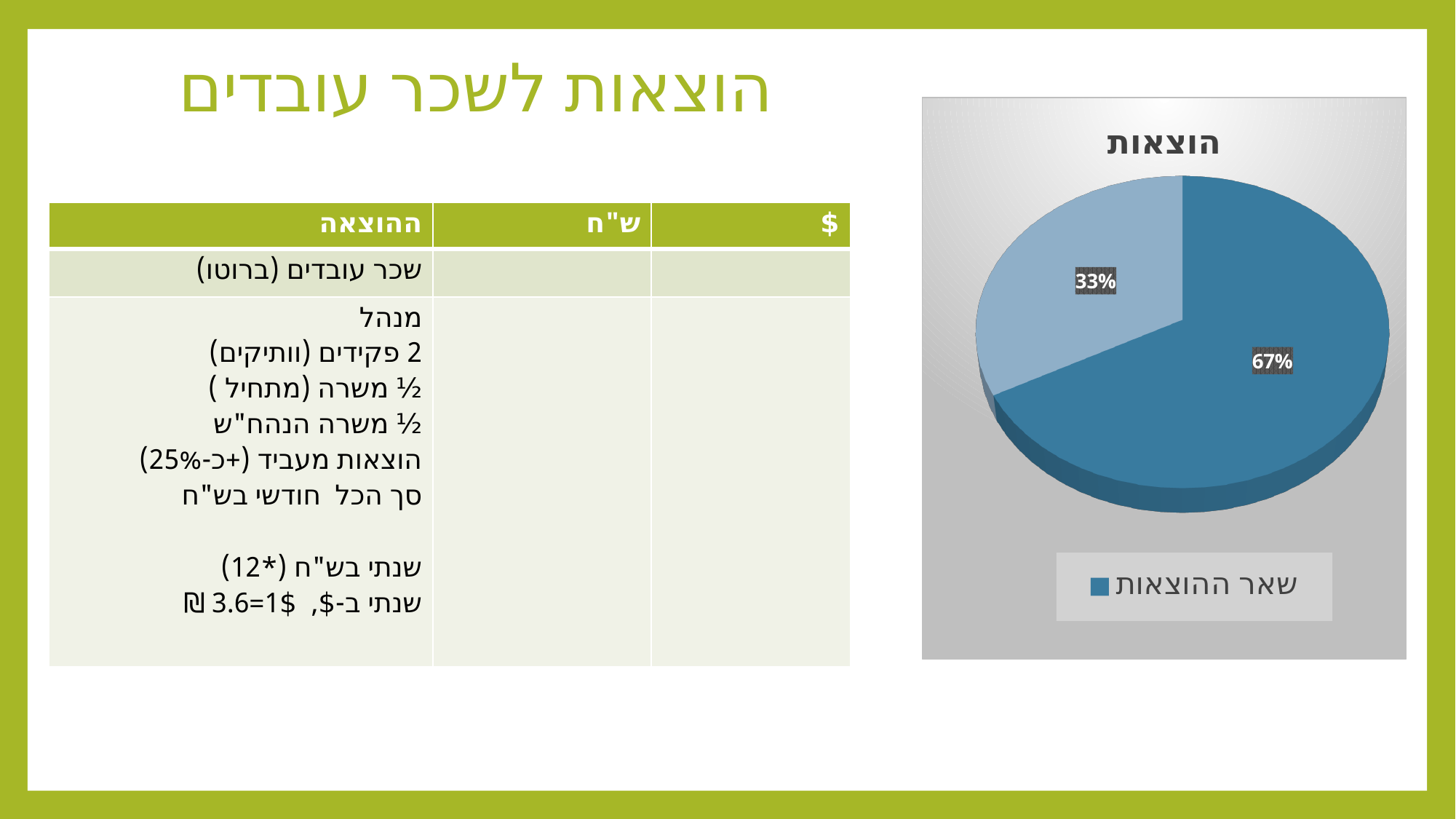
What is the legend entry shown below the pie chart? שאר ההוצאות Which slice is the smallest in the pie chart? the light blue slice (33%) How many slices does the pie chart have? 2 What kind of chart is shown on the slide? pie chart Which slice is the largest in the pie chart? שאר ההוצאות (67%) Which is larger: the dark blue slice or the light blue slice? the dark blue slice What is the difference in percentage points between the 67% slice and the 33% slice? 34 What percentage is shown on the light blue slice of the pie? 33% What share of the pie does the slice labelled שאר ההוצאות (dark blue) take? 67% How many entries does the chart's legend list? 1 What is the title of the chart? הוצאות